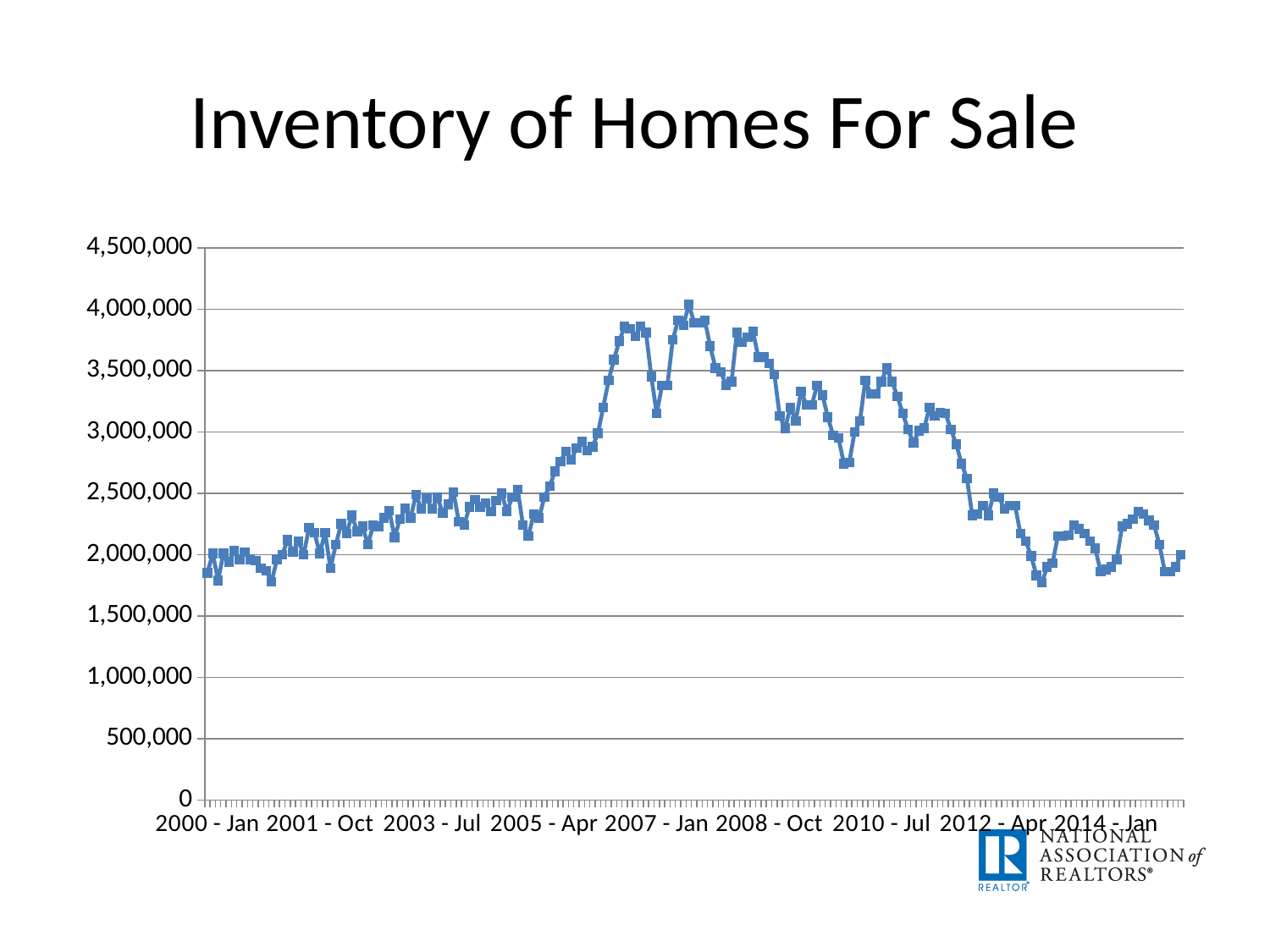
Is the lowest value of the series greater or less than 2,000,000? less Is the value at 2003 - Jul greater or less than 3,000,000? less What is the highest value shown on the y axis? 4,500,000 How many date labels are shown along the x axis? 9 What kind of chart is shown on the slide? line chart Is the value at 2003 - Jul greater or less than 2,000,000? greater What is the title of the chart? Inventory of Homes For Sale Does the inventory generally rise or fall between 2000 - Jan and 2007 - Jan? rise Does the inventory generally rise or fall between 2008 - Oct and 2014 - Jan? fall